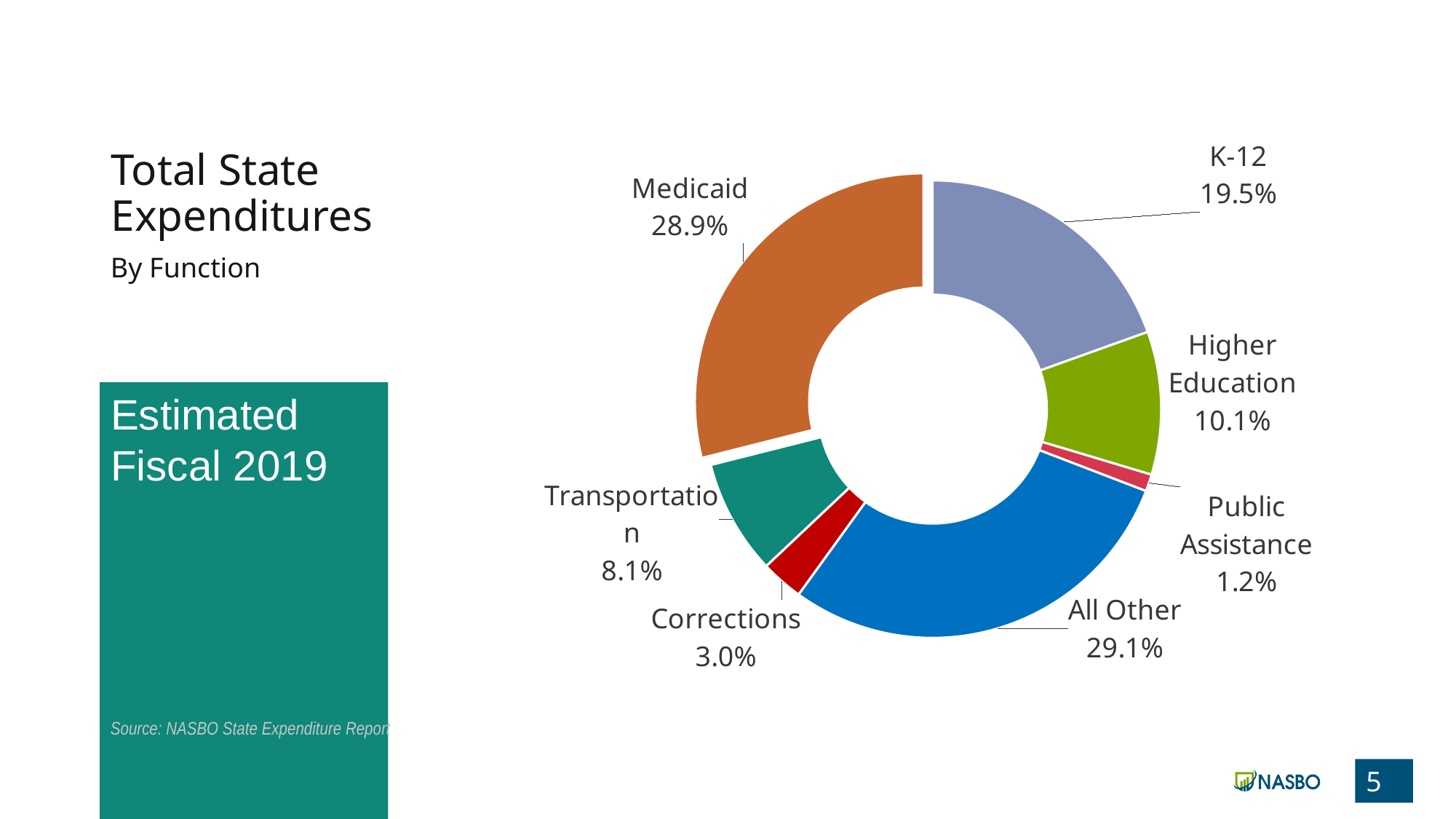
What share of total state expenditures goes to Public Assistance? 1.2% What fiscal year does the chart cover? Estimated Fiscal 2019 Which has a larger share, Transportation or Corrections? Transportation What share of total state expenditures goes to Corrections? 3.0% What kind of chart is shown on the slide? Pie chart (doughnut) Which function has the largest share of total state expenditures? All Other How many functions are shown in the chart? 7 What is the difference in share between Medicaid and K-12? 9.4% What share of total state expenditures goes to Medicaid? 28.9% What share of total state expenditures goes to K-12? 19.5% Which function has the smallest share of total state expenditures? Public Assistance What share of total state expenditures goes to Higher Education? 10.1%